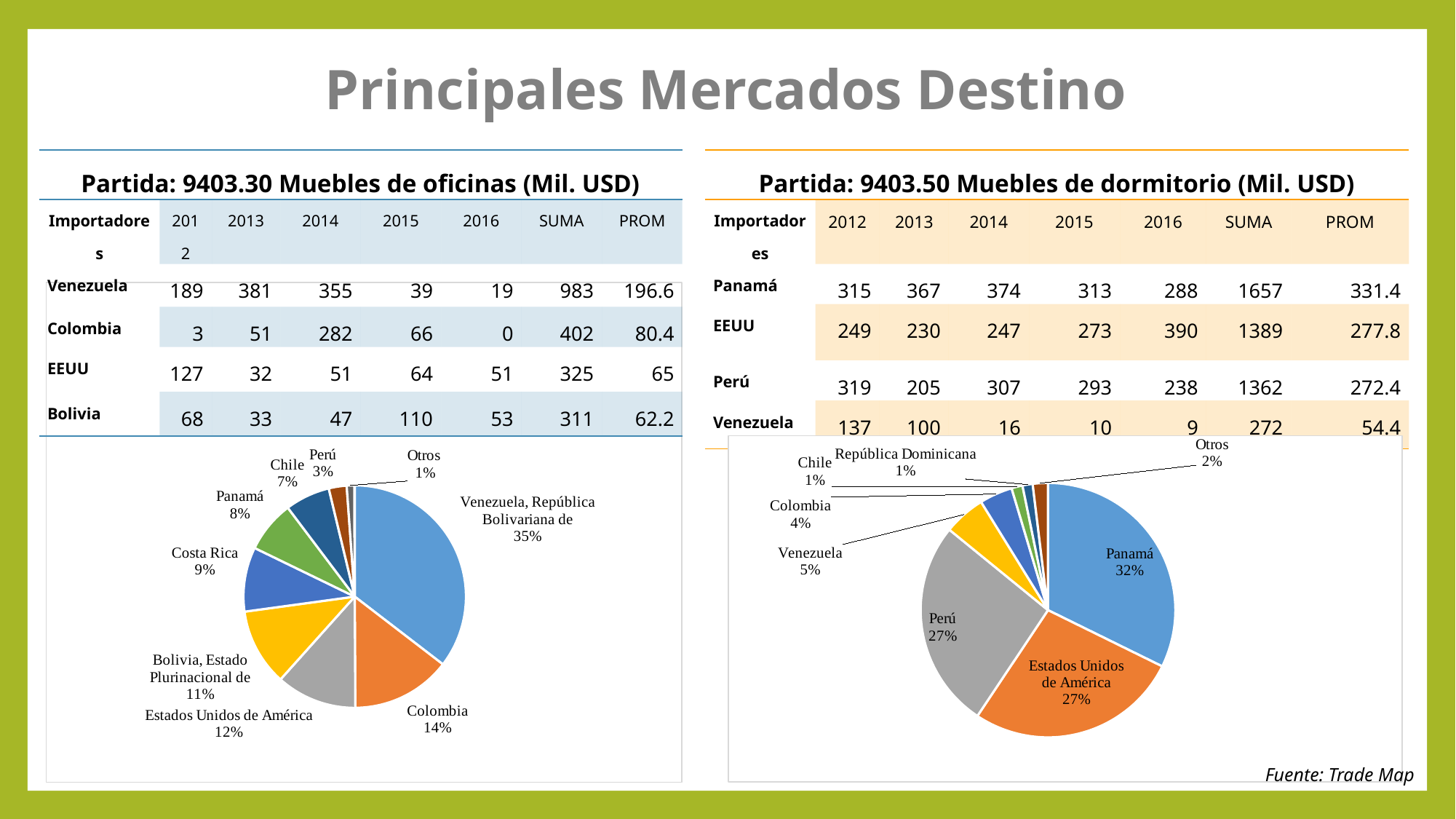
In the right pie chart (Muebles de dormitorio), which category has the largest slice? Panamá In the right pie chart (Muebles de dormitorio), what is the difference in percentage points between Panamá and Perú? 5 In the left pie chart (Muebles de oficinas), what share does Colombia have? 14% In the right pie chart (Muebles de dormitorio), which is larger: Venezuela or Colombia? Venezuela In the left pie chart (Muebles de oficinas), which is larger: Bolivia or Panamá? Bolivia, Estado Plurinacional de In the left pie chart (Muebles de oficinas), what is the difference in percentage points between Costa Rica and Chile? 2 In the left pie chart (Muebles de oficinas), how many slices are shown? 9 In the left pie chart (Muebles de oficinas), which labelled category has the smallest slice? Otros In the left pie chart (Muebles de oficinas), which category has the largest slice? Venezuela, República Bolivariana de What type of chart is used on the left side of the slide? Pie chart In the right pie chart (Muebles de dormitorio), what share does Panamá have? 32% In the right pie chart (Muebles de dormitorio), how many slices are shown? 8